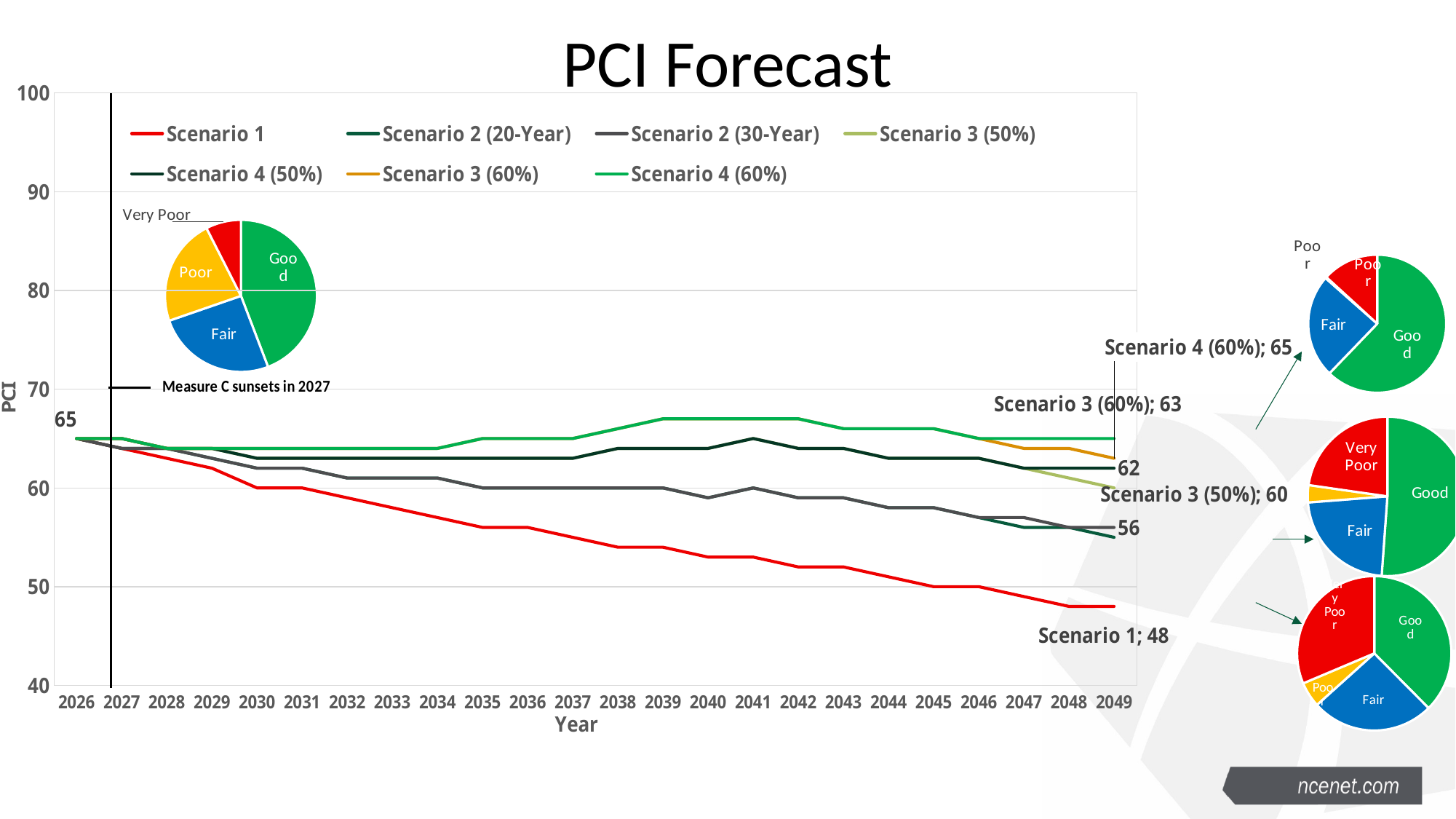
In the PCI Forecast chart, does the Scenario 1 line rise or fall from 2026 to 2049? fall What kind of chart is the PCI Forecast chart? line chart In the PCI Forecast chart, what does the annotation next to the vertical line at 2027 say? Measure C sunsets in 2027 In the PCI Forecast chart, what is the difference between Scenario 4 (60%) and Scenario 1 in 2049? 17 In the PCI Forecast chart, is the value for Scenario 1 in 2040 greater or less than 60? less In the PCI Forecast chart, what is the PCI value for Scenario 3 (60%) in 2049? 63 In the PCI Forecast chart, what is the PCI value for Scenario 4 (60%) in 2049? 65 In the PCI Forecast chart, what is the PCI value for Scenario 1 in 2049? 48 In the PCI Forecast chart, which series has the lowest PCI value in 2049? Scenario 1 In the PCI Forecast chart, what is the PCI value for Scenario 3 (50%) in 2049? 60 How many series does the legend of the PCI Forecast chart list? 7 In the PCI Forecast chart, what is the starting PCI value labelled at 2026? 65